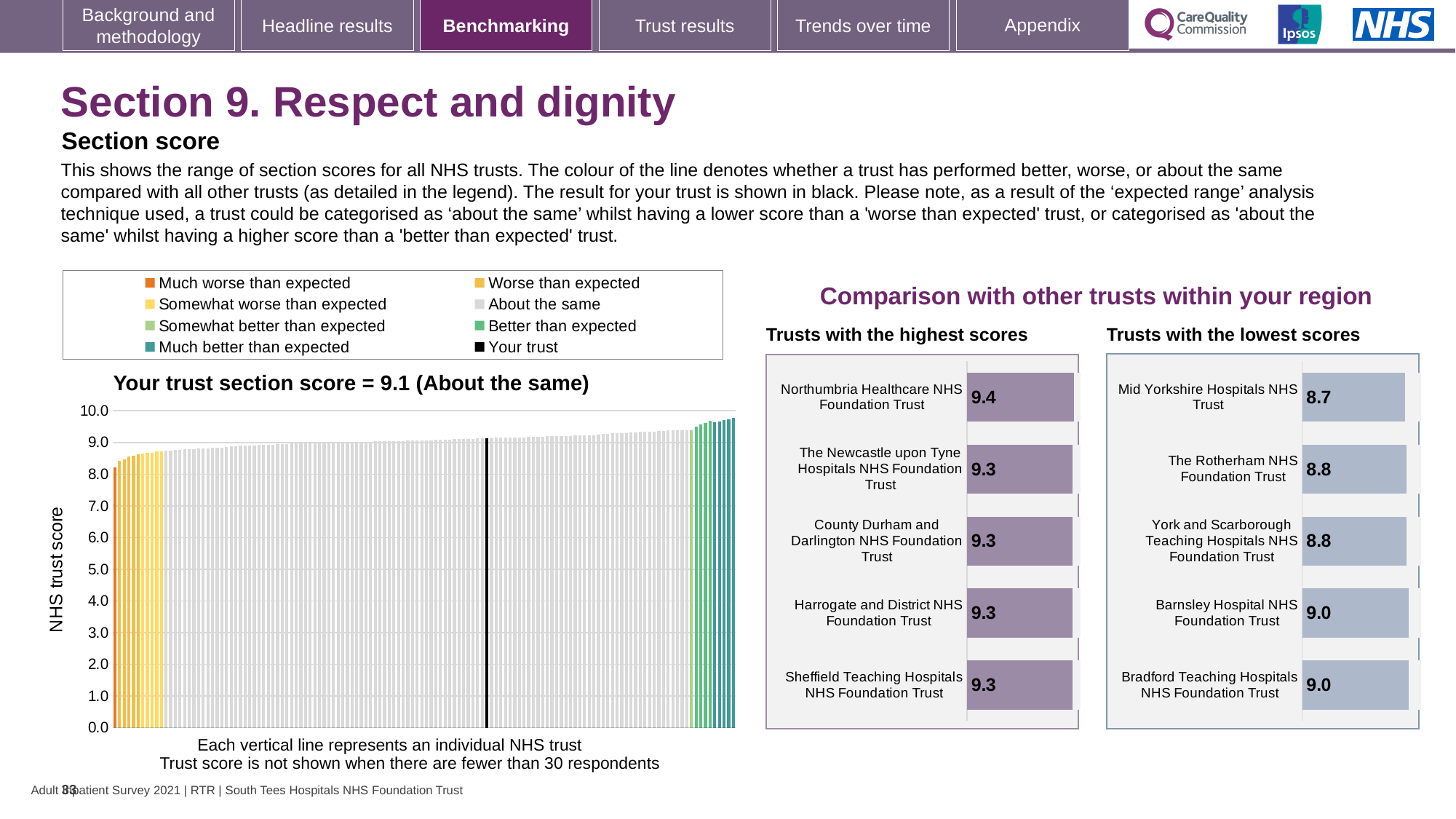
In the large chart on the left, do the trust scores rise or fall from left to right along the x axis? Rise In the 'Trusts with the highest scores' chart, which trust has the highest score? Northumbria Healthcare NHS Foundation Trust In the 'Trusts with the highest scores' chart, what is the score for Northumbria Healthcare NHS Foundation Trust? 9.4 In the 'Trusts with the highest scores' chart, how many trusts are listed? 5 In the 'Trusts with the lowest scores' chart, which is larger: the score for Barnsley Hospital NHS Foundation Trust or The Rotherham NHS Foundation Trust? Barnsley Hospital NHS Foundation Trust In the 'Trusts with the lowest scores' chart, which trust has the lowest score? Mid Yorkshire Hospitals NHS Trust In the large chart on the left, what is the section score for your trust? 9.1 In the 'Trusts with the lowest scores' chart, what is the difference between the scores of Bradford Teaching Hospitals NHS Foundation Trust and Mid Yorkshire Hospitals NHS Trust? 0.3 In the 'Trusts with the lowest scores' chart, what is the score for Mid Yorkshire Hospitals NHS Trust? 8.7 What kind of chart is the large chart on the left showing the range of section scores for all NHS trusts? Bar chart In the 'Trusts with the highest scores' chart, what is the difference between the scores of Northumbria Healthcare NHS Foundation Trust and Sheffield Teaching Hospitals NHS Foundation Trust? 0.1 In the 'Trusts with the lowest scores' chart, what is the score for York and Scarborough Teaching Hospitals NHS Foundation Trust? 8.8